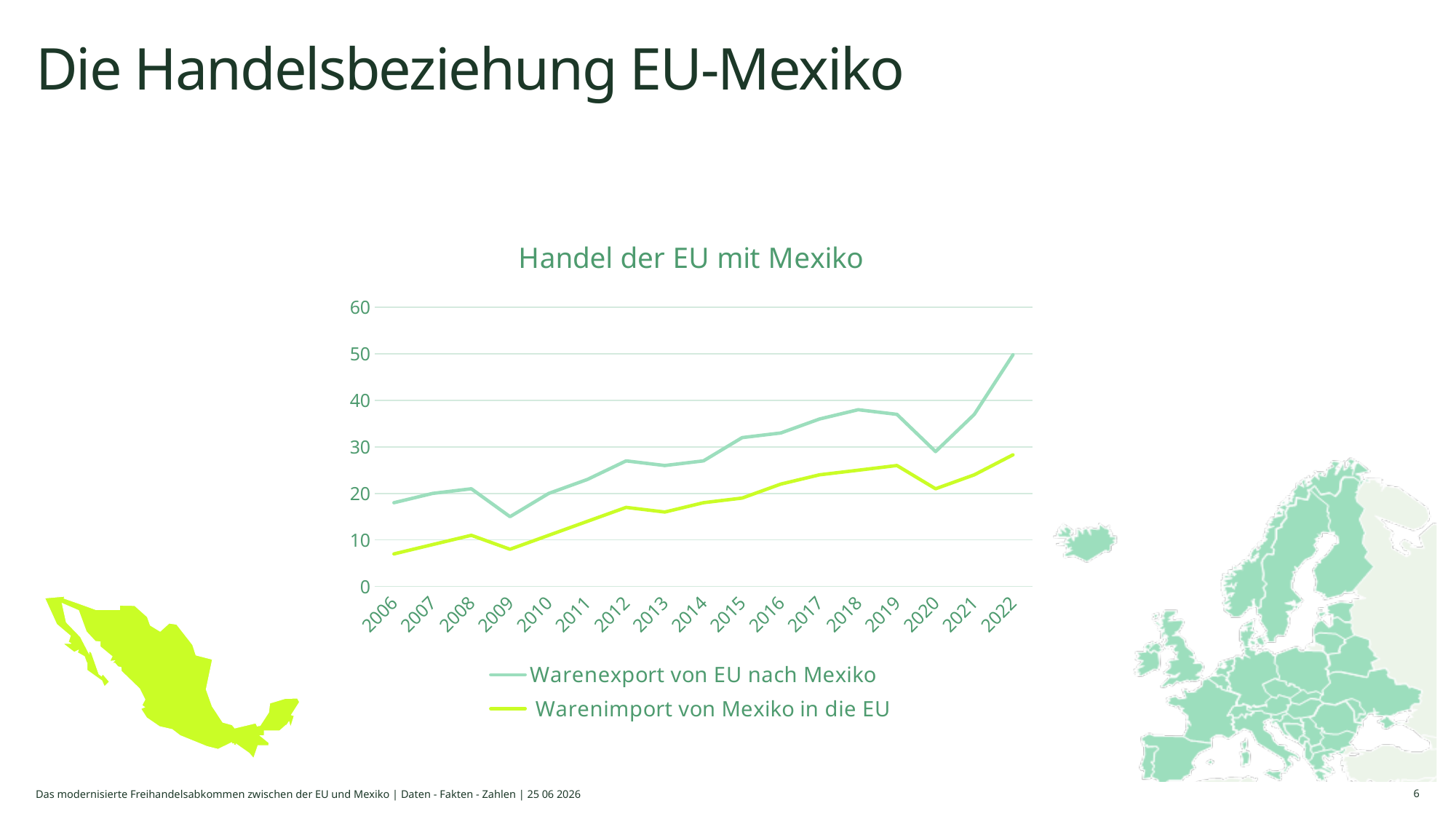
How many series does the legend of the chart list? 2 In which year is the value for Warenimport von Mexiko in die EU lowest? 2006 Is the value for Warenexport von EU nach Mexiko in 2018 greater or less than 30? greater Does the value for Warenimport von Mexiko in die EU generally rise or fall from 2006 to 2022? rise Which series has the larger value in 2015, Warenexport von EU nach Mexiko or Warenimport von Mexiko in die EU? Warenexport von EU nach Mexiko Which series is drawn in the bright yellow-green line? Warenimport von Mexiko in die EU In which year is the value for Warenexport von EU nach Mexiko highest? 2022 Is the value for Warenimport von Mexiko in die EU in 2009 greater or less than 10? less What is the title of the chart? Handel der EU mit Mexiko In which year is the value for Warenexport von EU nach Mexiko lowest? 2009 How many years are plotted along the x axis of the chart? 17 What kind of chart is shown on the slide? line chart